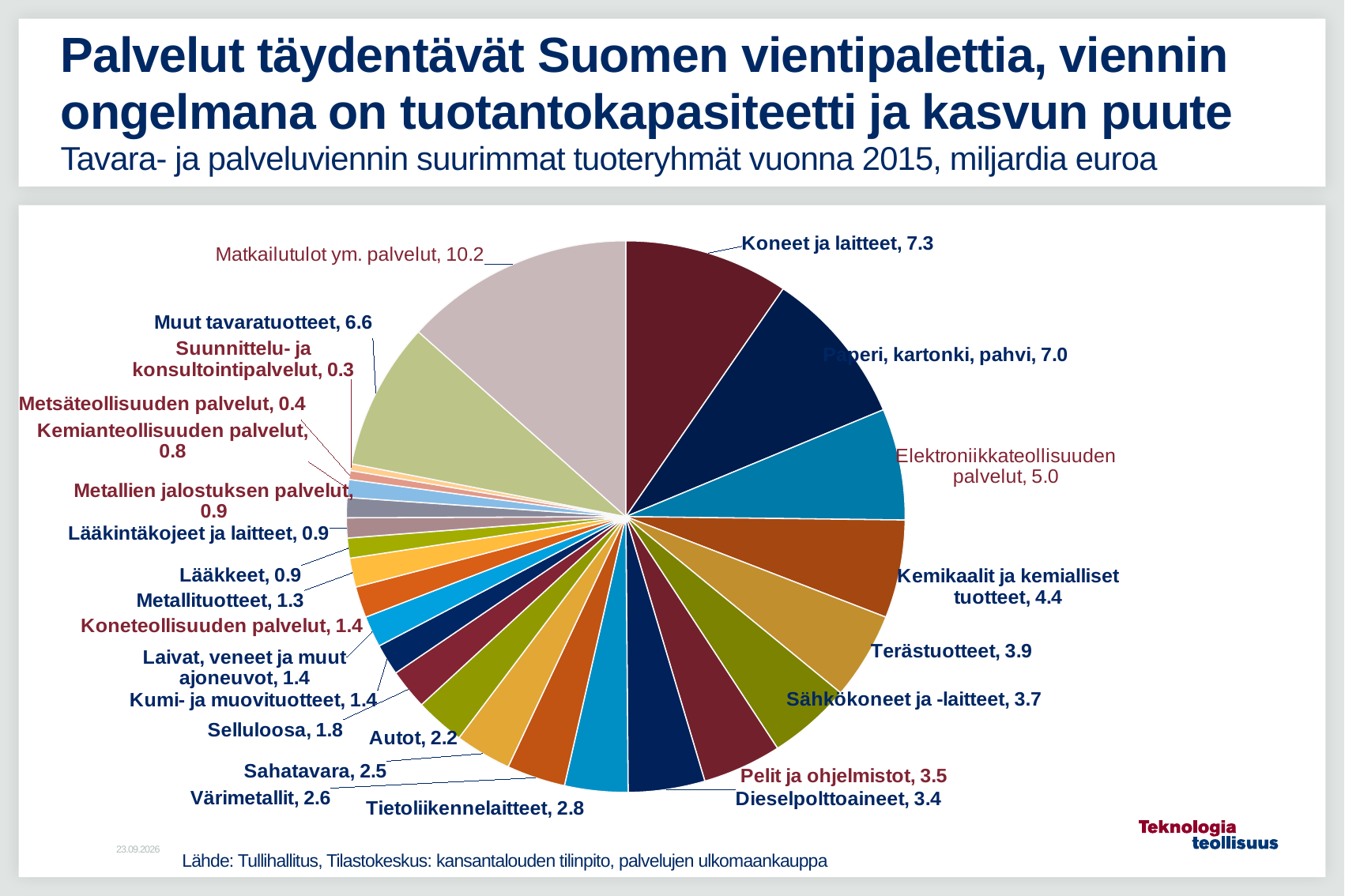
What is the value for Koneet ja laitteet? 7.3 Which category has the largest slice of the pie? Matkailutulot ym. palvelut What is the value for Muut tavaratuotteet? 6.6 What is the subtitle describing the chart's data? Tavara- ja palveluviennin suurimmat tuoteryhmät vuonna 2015, miljardia euroa What is the value for Pelit ja ohjelmistot? 3.5 What is the difference between Matkailutulot ym. palvelut and Koneet ja laitteet? 2.9 What is the difference between Koneet ja laitteet and Paperi, kartonki, pahvi? 0.3 What is the value for Elektroniikkateollisuuden palvelut? 5.0 What kind of chart is shown on the slide? pie chart Which category has the smallest slice of the pie? Suunnittelu- ja konsultointipalvelut How many slices does the pie chart have? 25 Which is larger, Terästuotteet or Sähkökoneet ja -laitteet? Terästuotteet